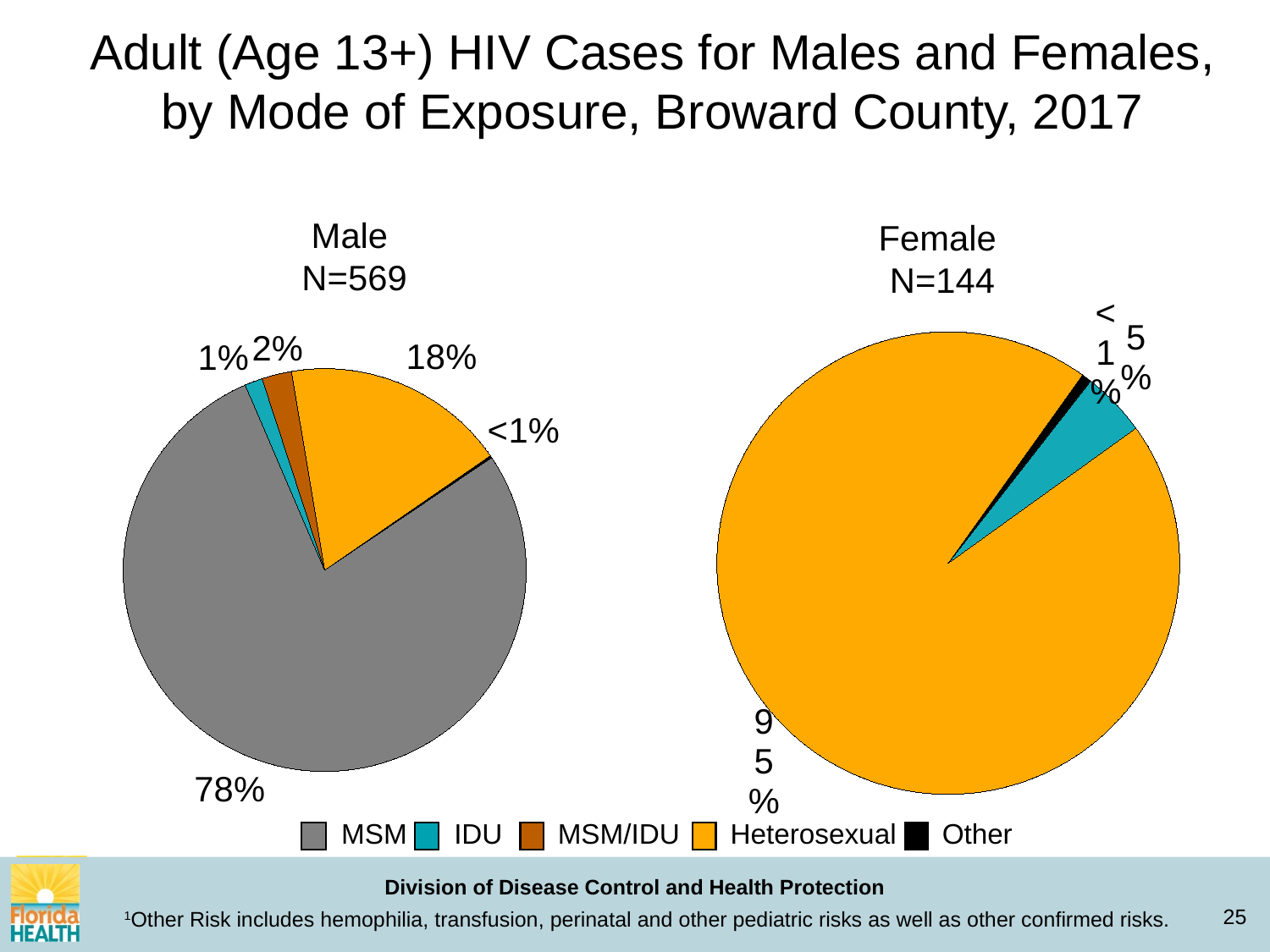
In the Male pie chart, what share of cases is attributed to IDU? 1% In the Male pie chart, what share of cases is attributed to MSM/IDU? 2% In the Female pie chart, what share of cases is attributed to Heterosexual exposure? 95% Which is larger: the Heterosexual share in the Male pie chart or the Heterosexual share in the Female pie chart? Female What kind of charts are shown on the slide? Pie charts In the Female pie chart, which mode of exposure has the largest share? Heterosexual How many modes of exposure does the legend list? 5 In the Male pie chart, how many percentage points larger is the MSM share than the Heterosexual share? 60 In the Male pie chart, which mode of exposure has the largest share? MSM